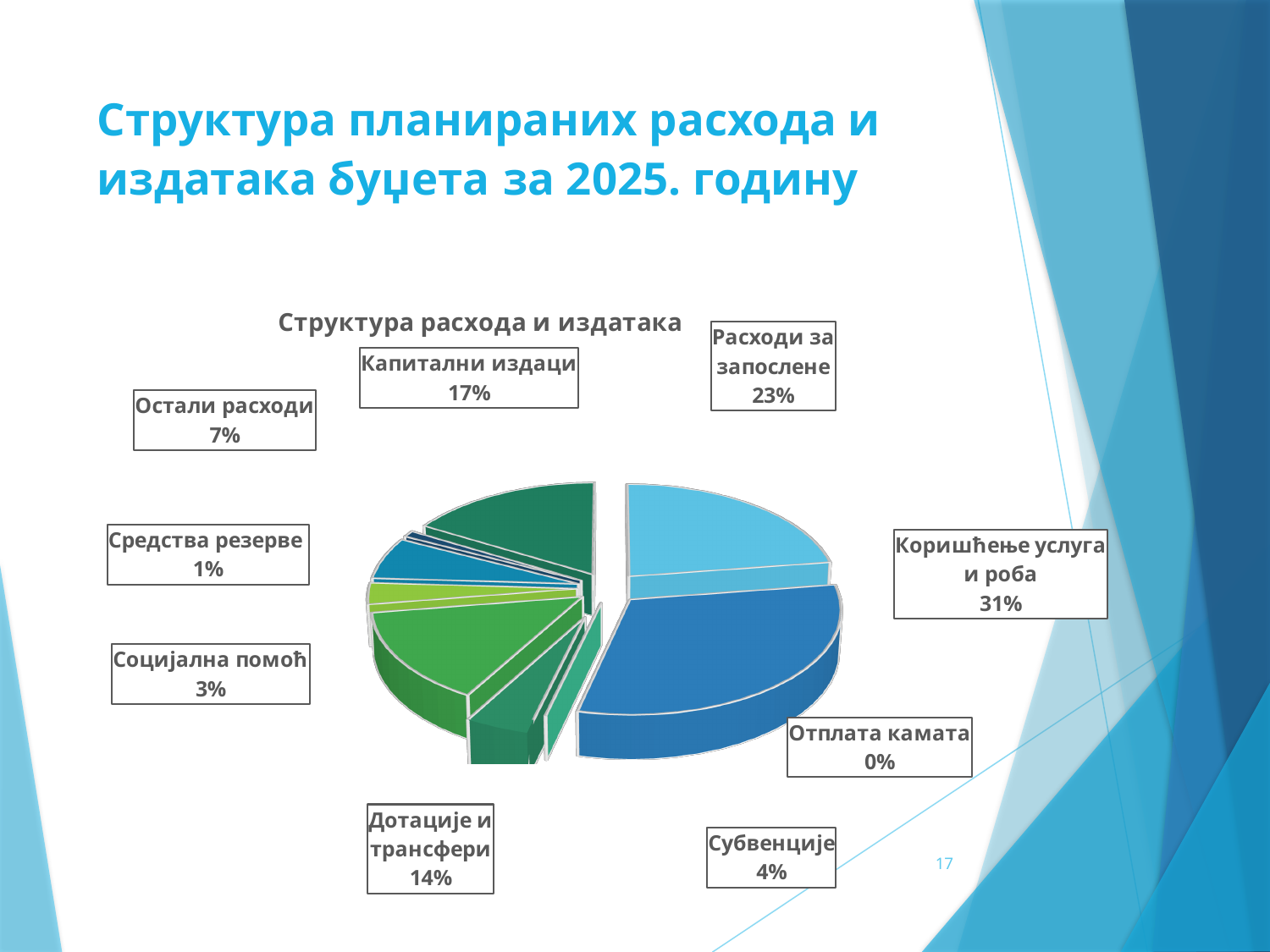
What percentage is shown for Капитални издаци? 17% Which category has the smallest share of the pie? Отплата камата What type of chart is shown on the slide? pie chart Which category has the largest share of the pie? Коришћење услуга и роба What percentage is shown for Дотације и трансфери? 14% Which is larger, Субвенције or Социјална помоћ? Субвенције What is the difference in percentage points between Коришћење услуга и роба and Расходи за запослене? 8 What is the title of the chart? Структура расхода и издатака What percentage is shown for Расходи за запослене? 23% What share of the pie is Коришћење услуга и роба? 31% How many categories are shown in the pie chart? 9 What percentage is shown for Средства резерве? 1%